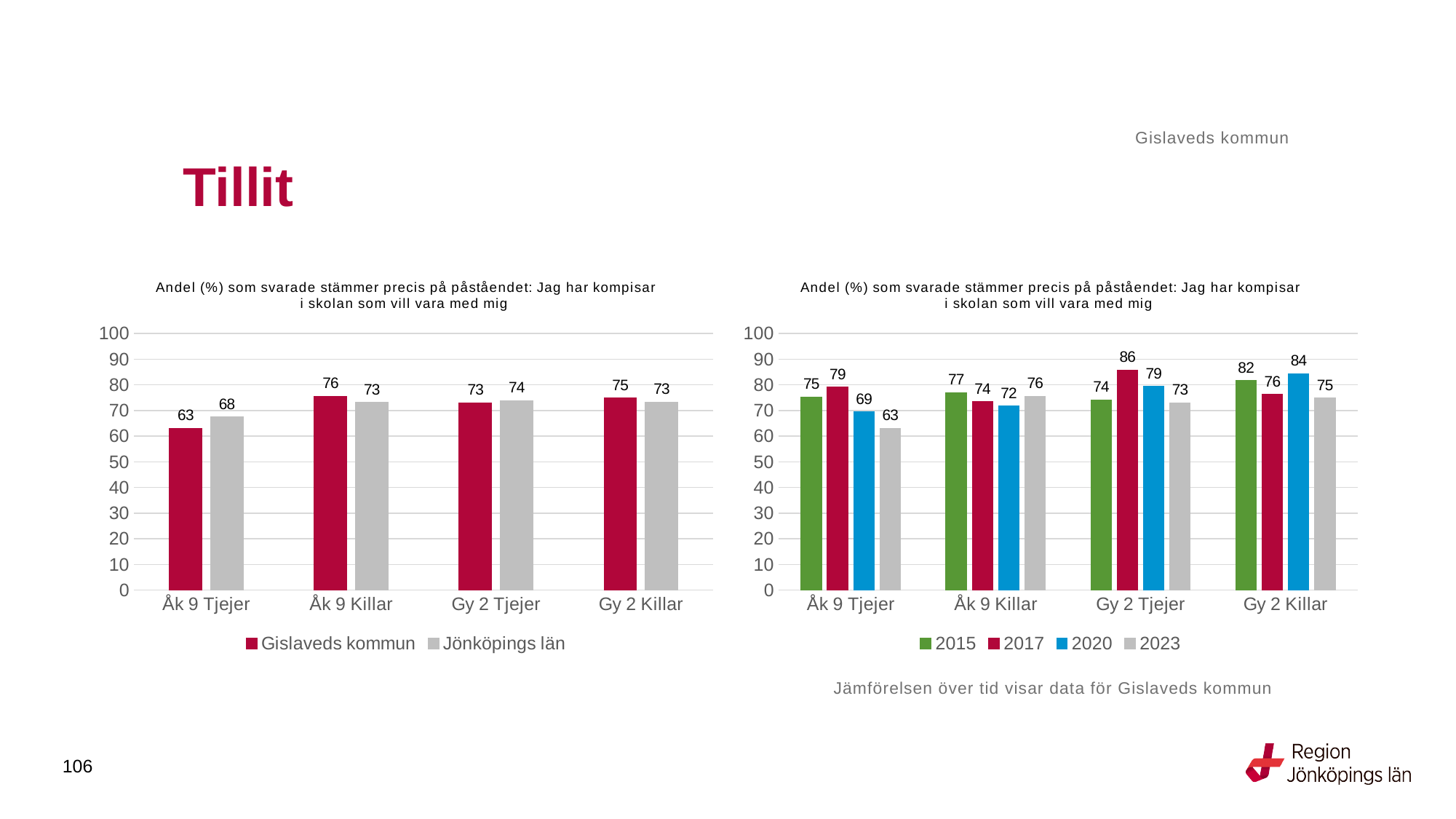
In the right chart, which year has the lowest value for Åk 9 Tjejer? 2023 In the right chart, what is the value for 2020 for Åk 9 Killar? 72 In the right chart, what is the difference between 2017 and 2023 for Gy 2 Tjejer? 13 In the left chart, what is the value for Jönköpings län for Gy 2 Tjejer? 74 In the left chart, what is the difference between Jönköpings län and Gislaveds kommun for Åk 9 Tjejer? 5 In the left chart, which category has the highest value for Gislaveds kommun? Åk 9 Killar In the right chart, which is larger for Gy 2 Killar: 2015 or 2020? 2020 In the left chart, how many series does the legend list? 2 In the left chart, what is the value for Gislaveds kommun for Åk 9 Tjejer? 63 In the right chart, how many series does the legend list? 4 What kind of chart is the right chart? Bar chart In the right chart, what is the value for 2017 for Gy 2 Tjejer? 86